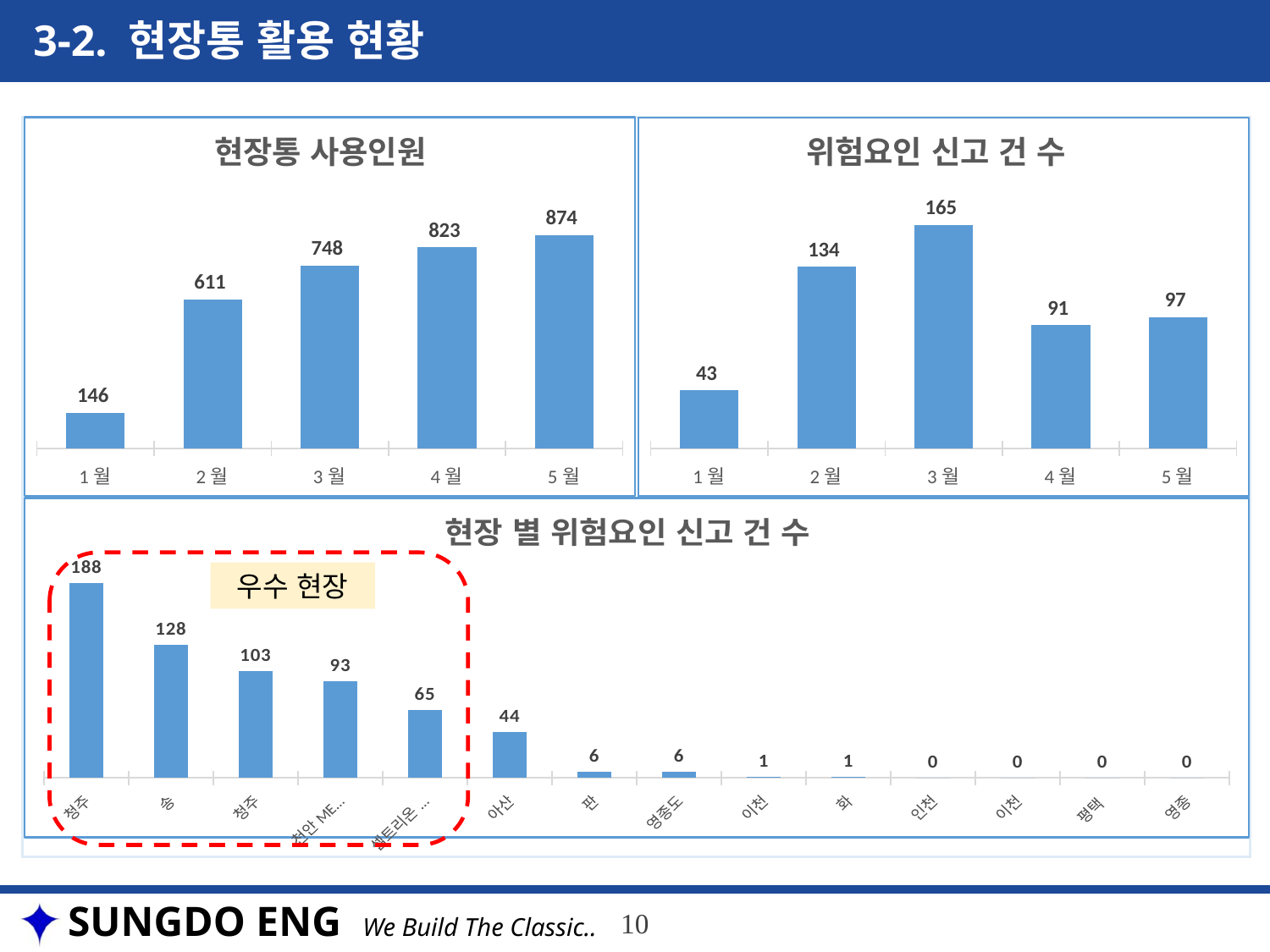
In the '위험요인 신고 건 수' chart, what is the difference between the values for 3 월 and 4 월? 74 In the '현장 별 위험요인 신고 건 수' chart, what is the highest value shown? 188 In the '위험요인 신고 건 수' chart, which month has the lowest value? 1 월 In the '현장통 사용인원' chart, what is the value for 3 월? 748 In the '현장 별 위험요인 신고 건 수' chart, what is the value for 아산? 44 What type of chart is the '현장 별 위험요인 신고 건 수' chart? bar chart In the '현장통 사용인원' chart, do the values rise or fall from 1 월 to 5 월? rise In the '위험요인 신고 건 수' chart, what is the value for 2 월? 134 In the '위험요인 신고 건 수' chart, which is larger, the value for 4 월 or 5 월? 5 월 How many months are shown in the '위험요인 신고 건 수' chart? 5 In the '현장통 사용인원' chart, which month has the highest value? 5 월 In the '현장통 사용인원' chart, what is the difference between the values for 5 월 and 1 월? 728